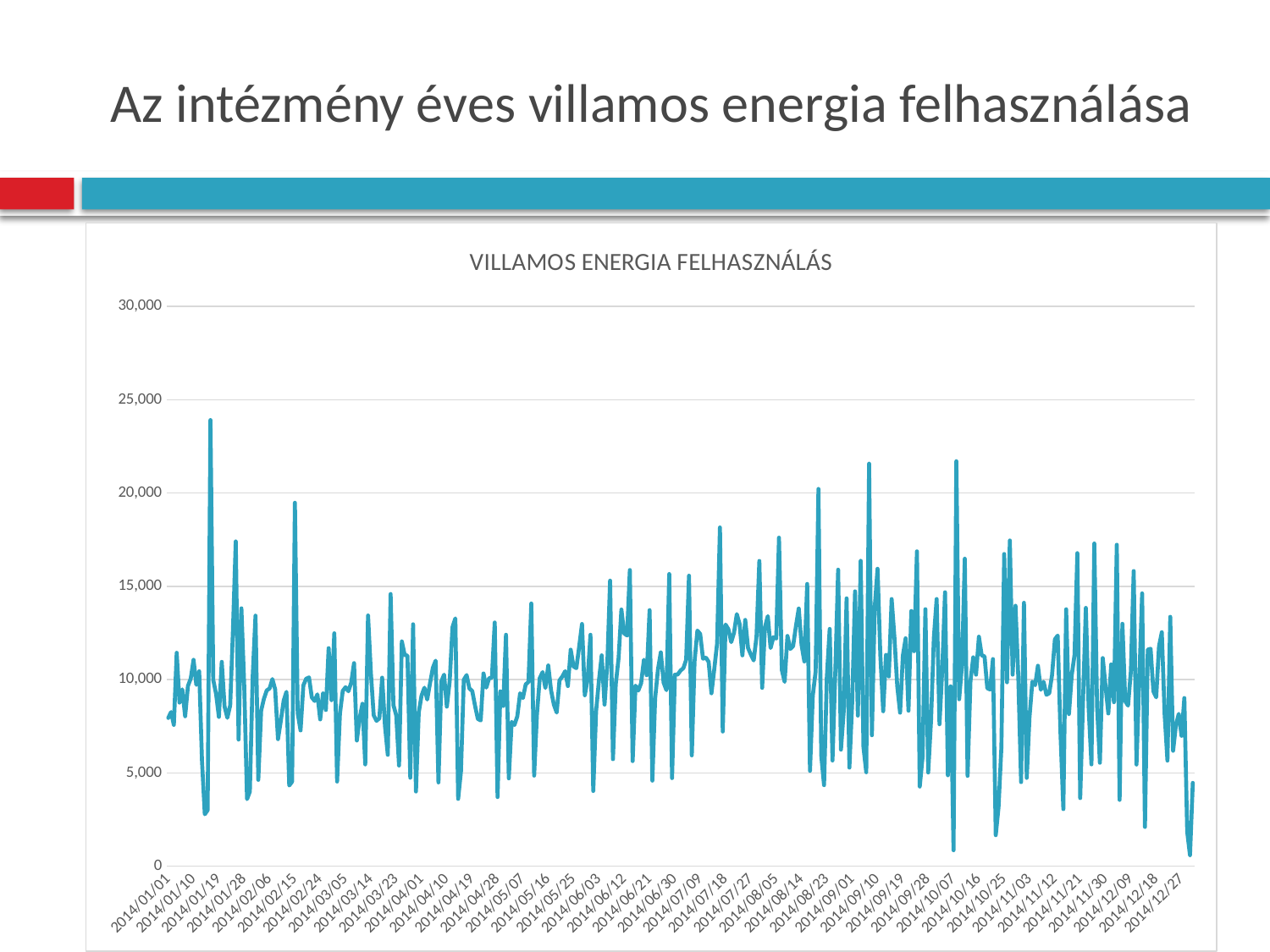
Which year does the data on the chart cover? 2014 Is the highest value reached on the chart greater or less than 25,000? less What kind of chart is shown on the slide? line chart What is the first date label on the horizontal axis? 2014/01/01 What is the title of the chart? VILLAMOS ENERGIA FELHASZNÁLÁS What is the maximum value shown on the vertical axis? 30,000 How many data series (lines) are plotted on the chart? 1 Is the lowest value reached on the chart greater or less than 5,000? less What is the last date label on the horizontal axis? 2014/12/27 Is the value at the first date, 2014/01/01, greater or less than 10,000? less